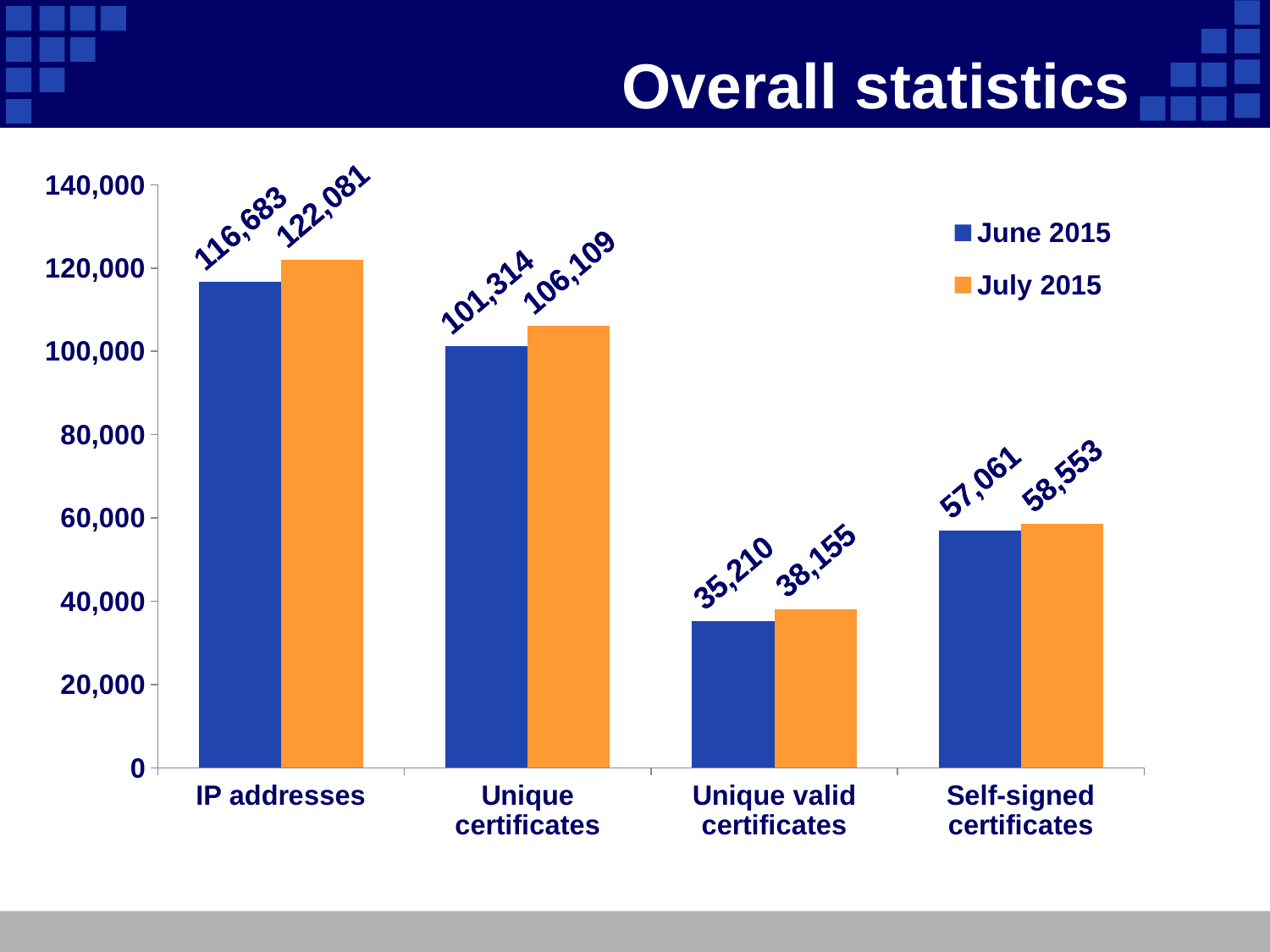
What is the difference between the July 2015 and June 2015 values for IP addresses? 5,398 What is the June 2015 value for IP addresses? 116,683 What is the July 2015 value for Unique valid certificates? 38,155 How many categories are shown on the x axis? 4 Which category has the lowest June 2015 value? Unique valid certificates What kind of chart is shown on the slide? bar chart How many series does the legend list? 2 What is the difference between the July 2015 and June 2015 values for Unique certificates? 4,795 Is the June 2015 value for Unique certificates greater or less than 100,000? greater Which is larger: the June 2015 value for Self-signed certificates or the July 2015 value for Unique valid certificates? June 2015 value for Self-signed certificates Which category has the highest July 2015 value? IP addresses What is the July 2015 value for Self-signed certificates? 58,553